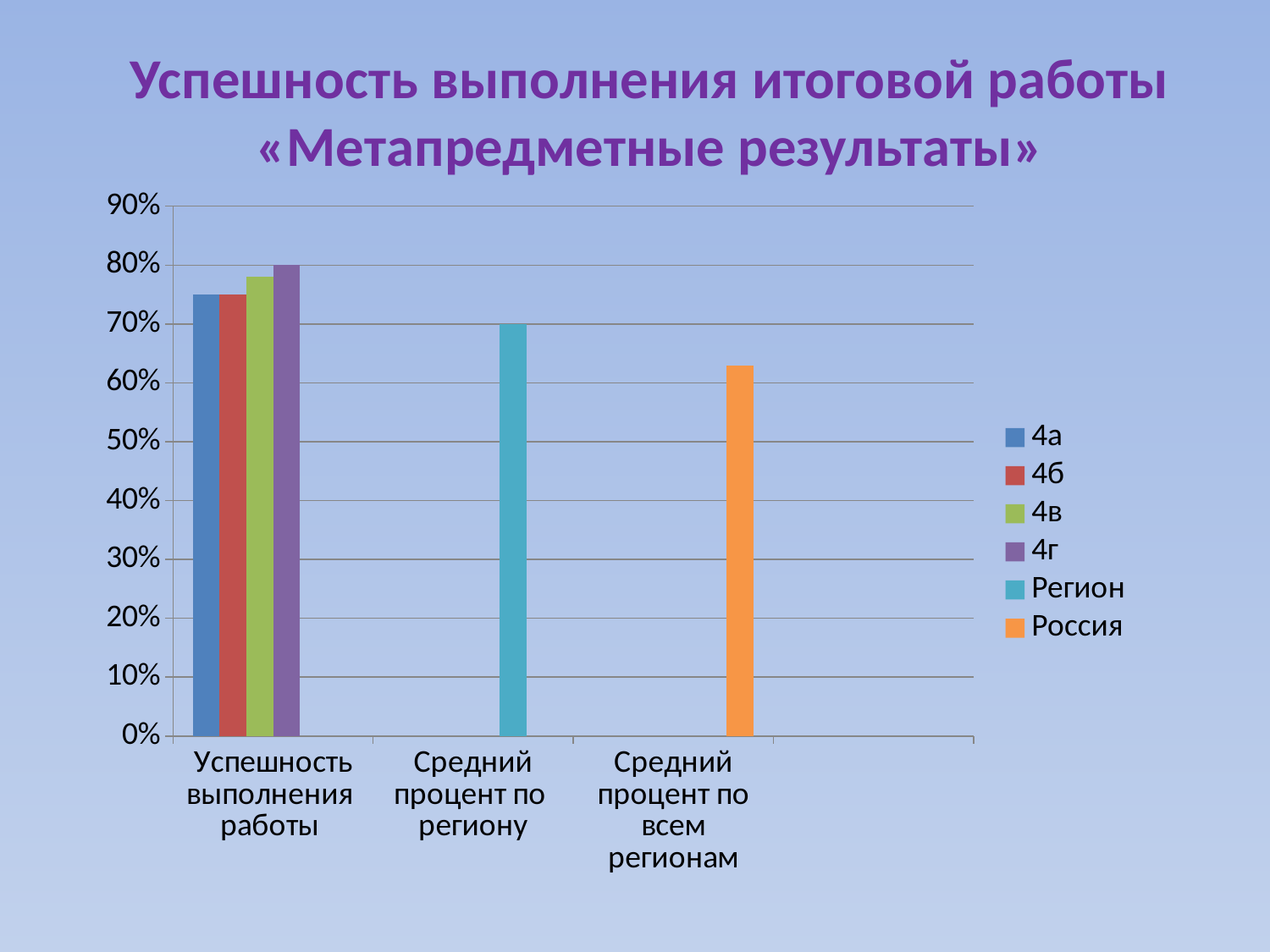
What kind of chart is shown on the slide? bar chart What is the value for the 4г series? 80% Which is larger, the value for 4б or the value for Россия? 4б What is the title of the slide? Успешность выполнения итоговой работы «Метапредметные результаты» How many categories are shown on the x axis? 3 Is the value for Россия greater or less than 60%? greater What is the value for the Регион series? 70% Is the value for 4а greater or less than 70%? greater How many series does the legend list? 6 Is the value for 4в greater or less than 80%? less Which is larger, the value for Регион or the value for Россия? Регион Which series has the lowest value? Россия